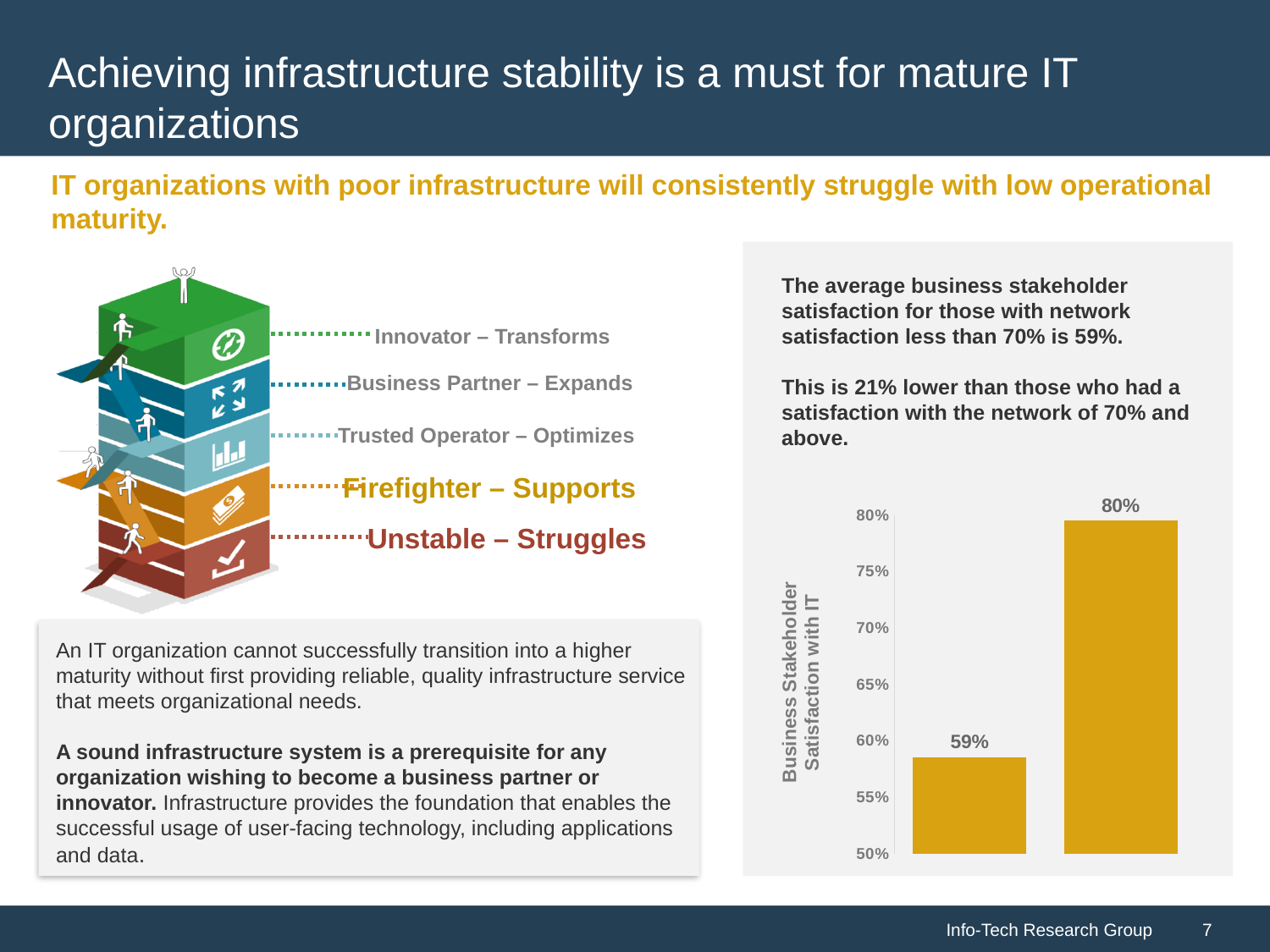
Which is larger in the chart, the left bar or the right bar? The right bar How many bars are plotted in the chart? 2 Which bar in the chart is the highest? The right bar What is the value of the left bar in the bar chart? 59% Is the value of the left bar in the chart greater or less than 60%? less What is the label on the vertical axis of the chart? Business Stakeholder Satisfaction with IT What is the difference between the right bar and the left bar in the chart? 21% Is the value of the right bar in the chart greater or less than 75%? greater What kind of chart is shown on the slide? Bar chart Do the bar values rise or fall from left to right in the chart? Rise What is the value of the right bar in the bar chart? 80% Which bar in the chart is the lowest? The left bar